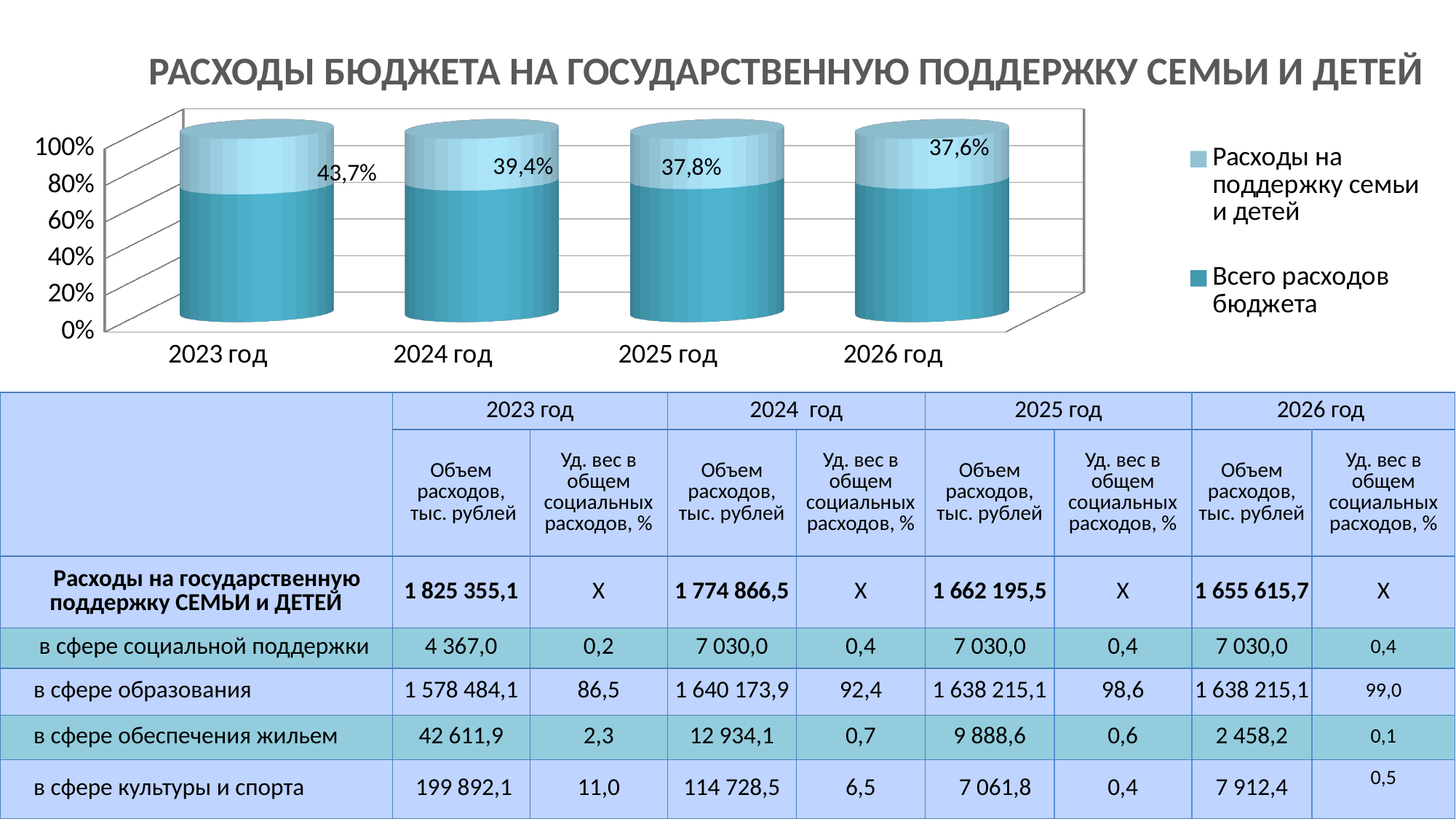
How many years are shown on the x axis of the chart? 4 Which year has the lowest labelled value in the chart? 2026 год What is the data label shown for 2025 год in the chart? 37,8% What kind of chart is shown on the slide? bar chart What is the data label shown for 2023 год in the chart? 43,7% Which year has the highest labelled value in the chart? 2023 год What is the difference between the labelled values for 2023 год and 2024 год? 4,3% What is the data label shown for 2024 год in the chart? 39,4% How many series does the chart legend list? 2 What is the data label shown for 2026 год in the chart? 37,6% Which is larger, the labelled value for 2024 год or for 2025 год? 2024 год Do the labelled values rise or fall from 2023 год to 2026 год? fall